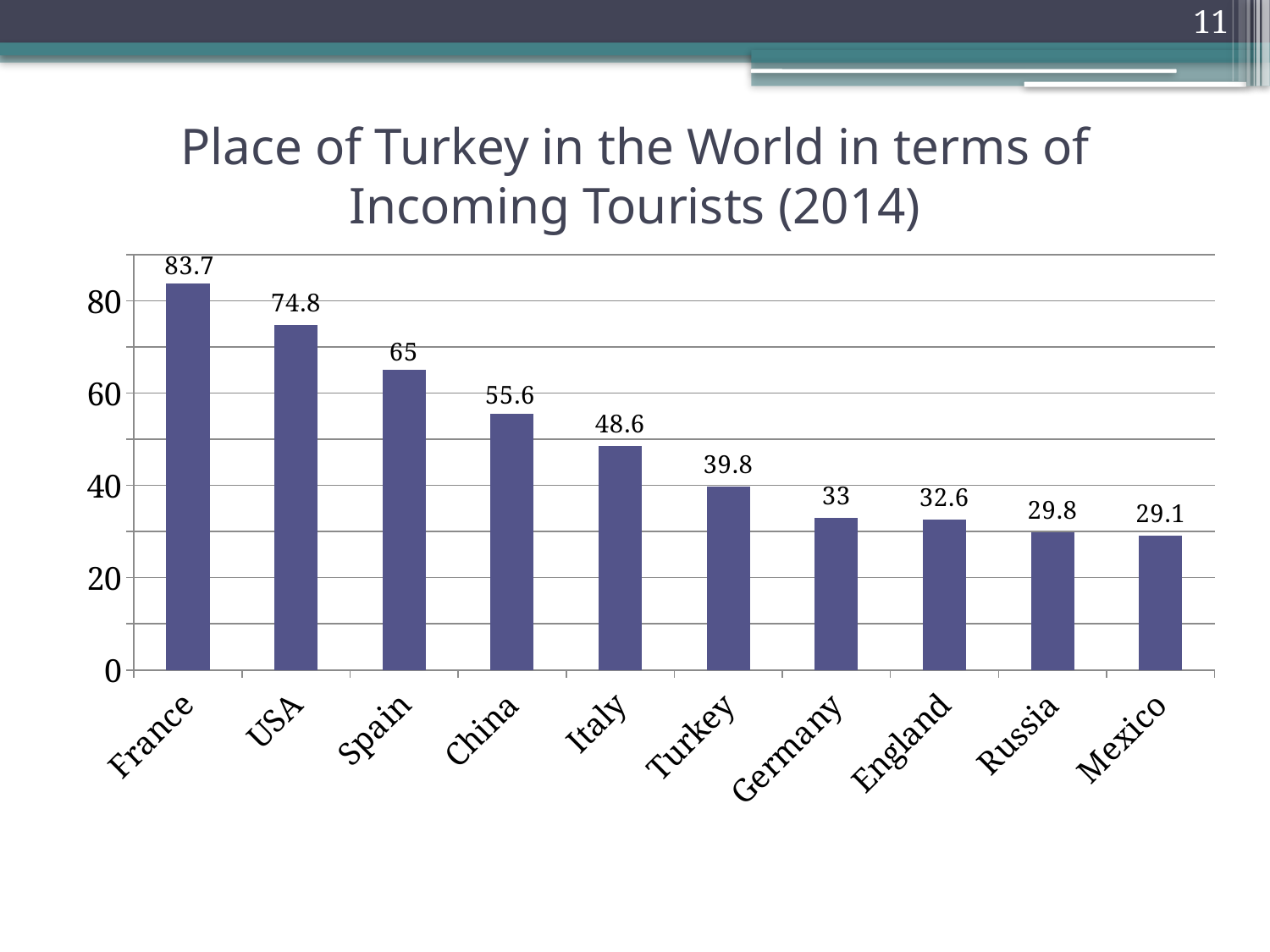
Is the value for England greater or less than 40? less Which has a larger value, China or Italy? China What is the difference between the values for France and USA? 8.9 What is the value for Turkey? 39.8 What is the value for Spain? 65 How many countries are shown in the chart? 10 Do the values rise or fall from left to right along the x axis? fall What is the difference between the values for Turkey and Germany? 6.8 What is the value for Russia? 29.8 Which country has the lowest value? Mexico What kind of chart is shown on the slide? bar chart Which country has the highest value? France